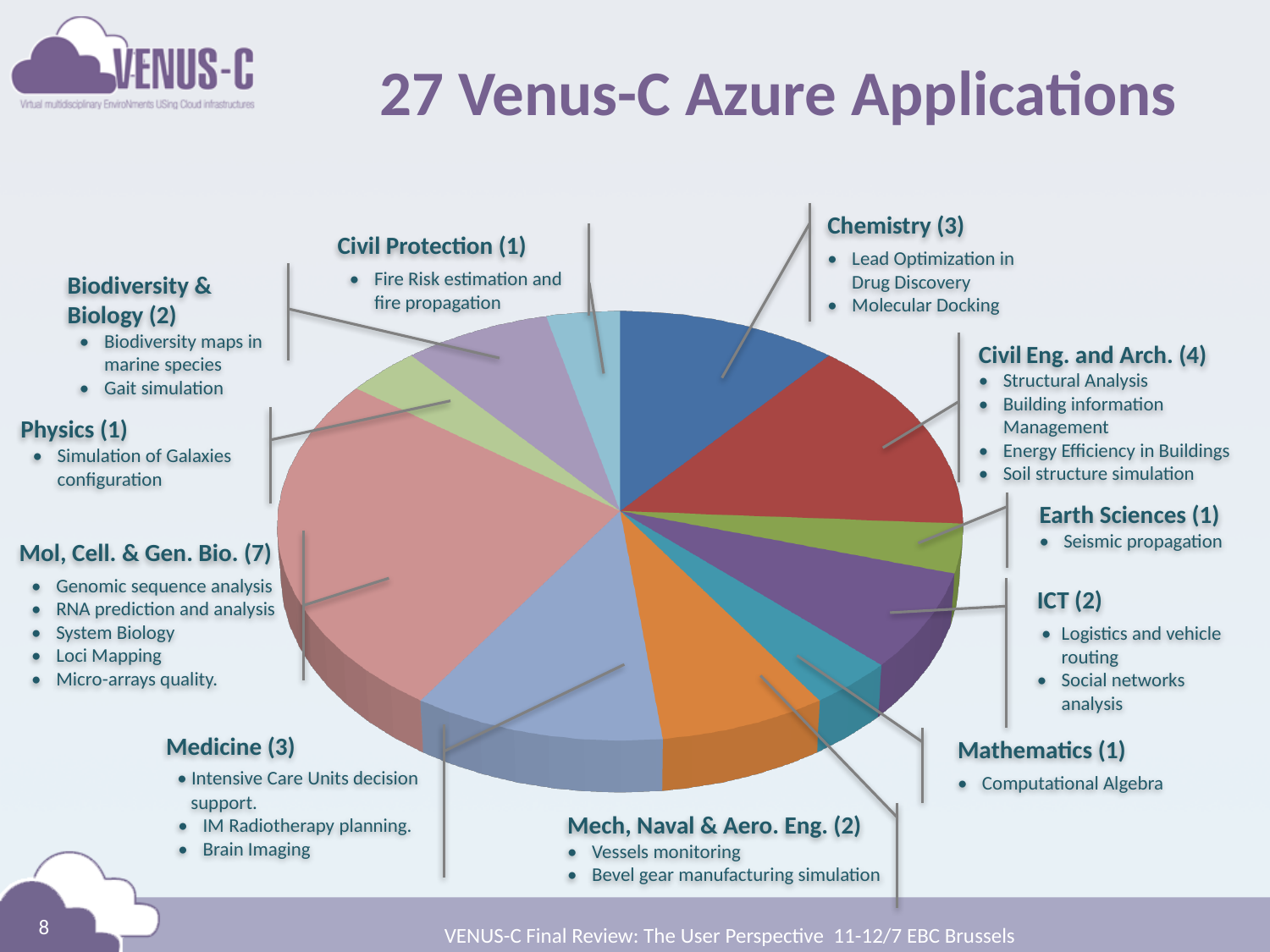
How many categories have exactly 1 application? 4 How many categories (slices) does the pie chart have? 11 What kind of chart is shown on the slide? pie chart Which has more applications, Chemistry or Civil Eng. and Arch.? Civil Eng. and Arch. How many applications does the ICT category have? 2 What is the title of the slide containing the pie chart? 27 Venus-C Azure Applications What is the difference between the number of applications in Mol, Cell. & Gen. Bio. and in Civil Eng. and Arch.? 3 How many applications does the Mol, Cell. & Gen. Bio. category have? 7 How many applications does the Civil Eng. and Arch. category have? 4 What is the total number of applications represented in the pie chart? 27 Which category has the largest number of applications? Mol, Cell. & Gen. Bio. How many applications does the Medicine category have? 3